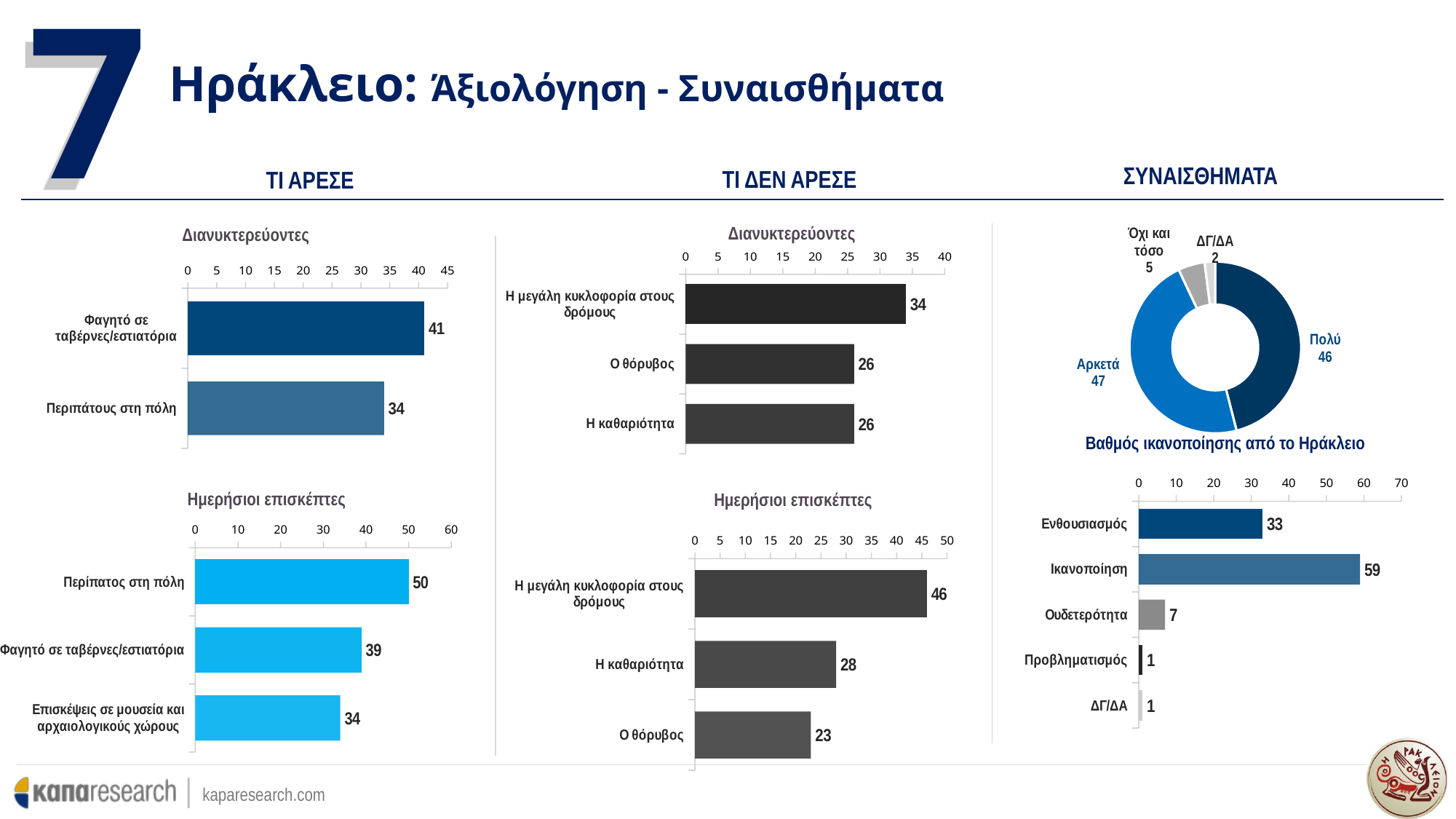
In the 'ΤΙ ΔΕΝ ΑΡΕΣΕ' chart for Ημερήσιοι επισκέπτες (bottom middle), which category has the lowest value? Ο θόρυβος In the ΣΥΝΑΙΣΘΗΜΑΤΑ bar chart (bottom right), what is the value for 'Ικανοποίηση'? 59 In the 'ΤΙ ΔΕΝ ΑΡΕΣΕ' chart for Ημερήσιοι επισκέπτες (bottom middle), how many categories are shown? 3 In the 'ΤΙ ΔΕΝ ΑΡΕΣΕ' chart for Ημερήσιοι επισκέπτες (bottom middle), is the value for 'Η μεγάλη κυκλοφορία στους δρόμους' larger than the value for 'Η καθαριότητα'? Yes In the 'ΤΙ ΑΡΕΣΕ' chart for Ημερήσιοι επισκέπτες (bottom left), what is the difference between 'Περίπατος στη πόλη' and 'Επισκέψεις σε μουσεία και αρχαιολογικούς χώρους'? 16 In the 'ΤΙ ΑΡΕΣΕ' chart for Ημερήσιοι επισκέπτες (bottom left), which category has the highest value? Περίπατος στη πόλη In the donut chart 'Βαθμός ικανοποίησης από το Ηράκλειο', what is the value for 'Αρκετά'? 47 In the ΣΥΝΑΙΣΘΗΜΑΤΑ bar chart (bottom right), what is the difference between 'Ικανοποίηση' and 'Ενθουσιασμός'? 26 What kind of chart is 'Βαθμός ικανοποίησης από το Ηράκλειο'? Donut chart In the 'ΤΙ ΑΡΕΣΕ' chart for Διανυκτερεύοντες (top left), what is the value for 'Φαγητό σε ταβέρνες/εστιατόρια'? 41 In the 'ΤΙ ΔΕΝ ΑΡΕΣΕ' chart for Διανυκτερεύοντες (top middle), what is the value for 'Ο θόρυβος'? 26 In the donut chart 'Βαθμός ικανοποίησης από το Ηράκλειο', which category has the smallest value? ΔΓ/ΔΑ